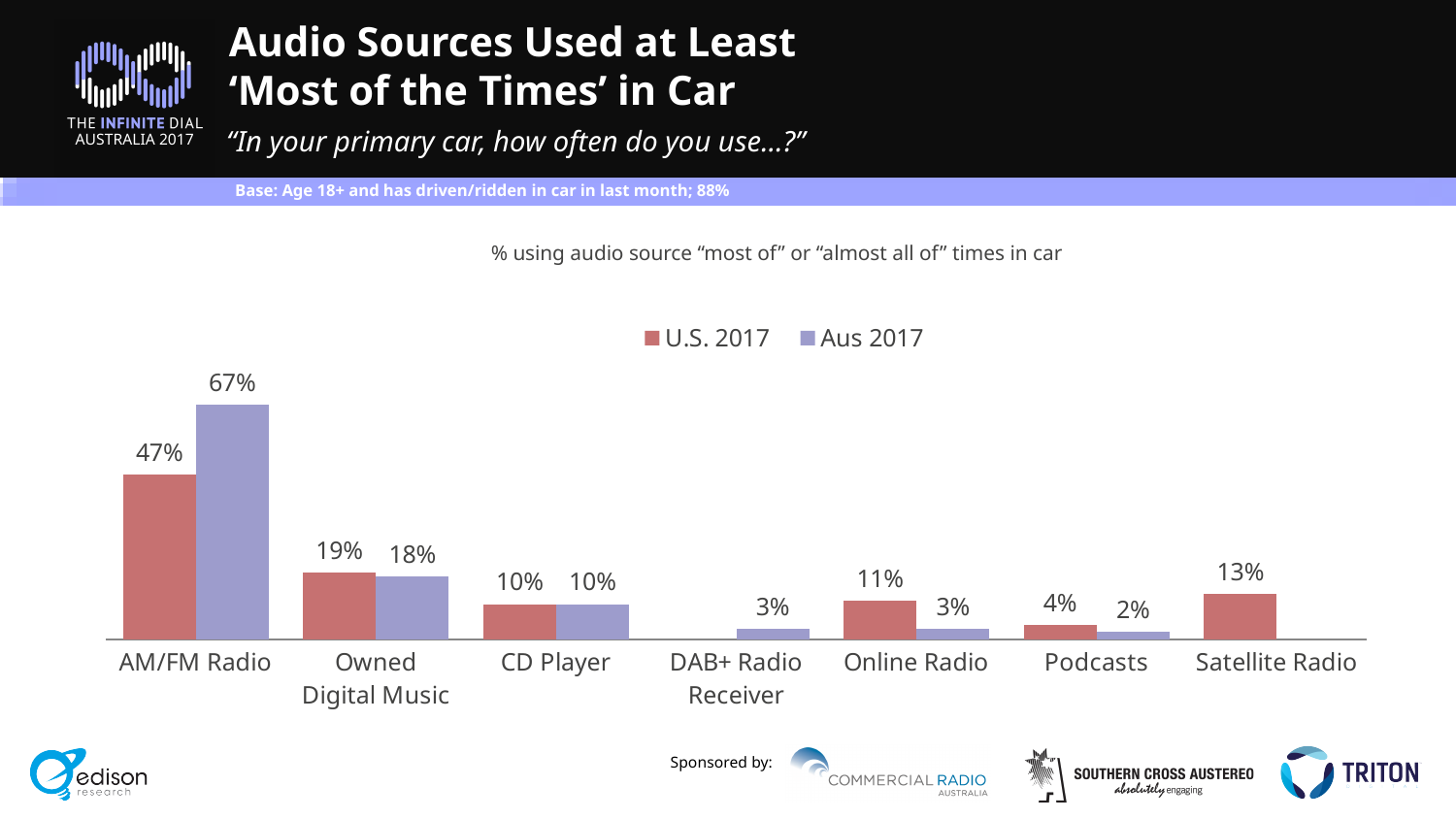
What is the U.S. 2017 value for Owned Digital Music? 19% Which is larger for Online Radio, the U.S. 2017 value or the Aus 2017 value? U.S. 2017 How many categories are shown on the x axis? 7 What is the difference between the Aus 2017 and U.S. 2017 values for AM/FM Radio? 20% What is the U.S. 2017 value for Satellite Radio? 13% What is the Aus 2017 value for DAB+ Radio Receiver? 3% What kind of chart is shown on the slide? Bar chart Which category has the highest Aus 2017 value? AM/FM Radio How many series does the legend list? 2 What is the Aus 2017 value for AM/FM Radio? 67% Which category has the lowest Aus 2017 value? Podcasts What are the two series named in the legend? U.S. 2017 and Aus 2017